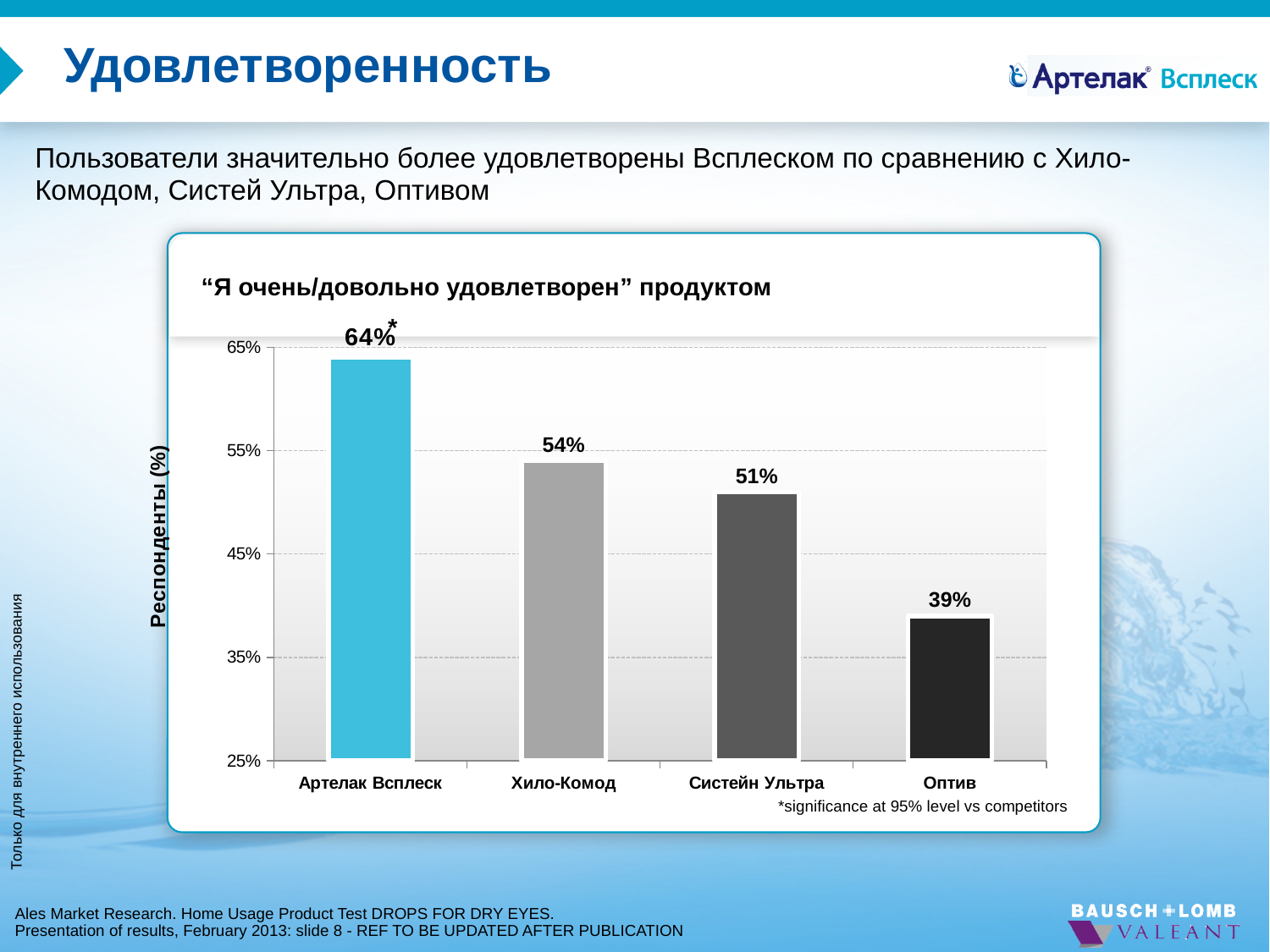
What is the value for Хило-Комод? 54% What is the value for Артелак Всплеск? 64% What is the label of the vertical axis of the chart? Респонденты (%) What is the value for Систейн Ультра? 51% What is the difference between the values for Артелак Всплеск and Хило-Комод? 10% Which is larger, the value for Хило-Комод or the value for Систейн Ультра? Хило-Комод What kind of chart is shown on the slide? Bar chart What is the value for Оптив? 39% What is the difference between the values for Систейн Ультра and Оптив? 12% Which product has the highest share of satisfied respondents? Артелак Всплеск Which product has the lowest share of satisfied respondents? Оптив How many products are shown in the chart? 4